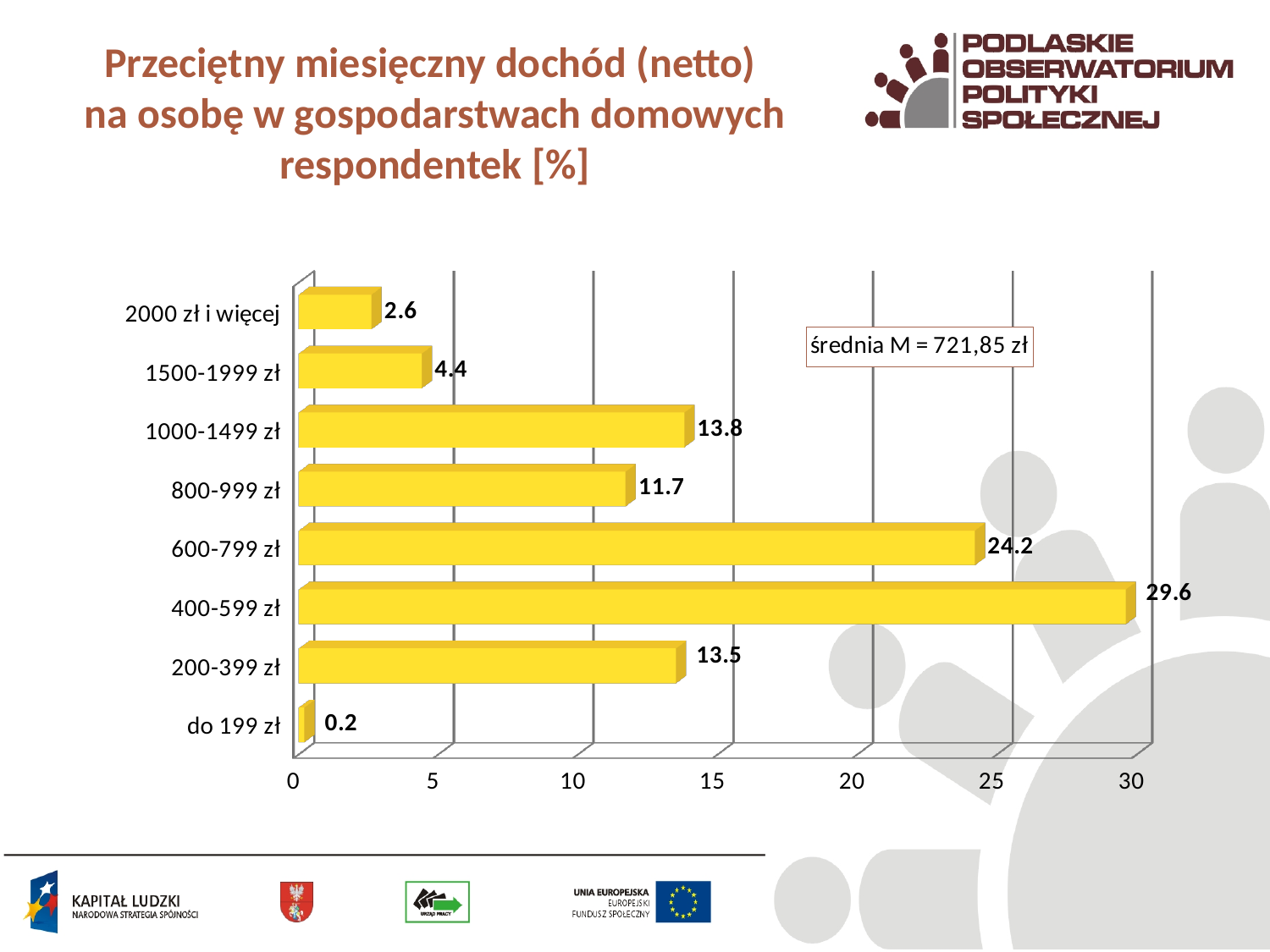
What is the difference between the values for 400-599 zł and 600-799 zł? 5.4 What is the value for the 1000-1499 zł category? 13.8 What is the mean value (średnia M) stated in the text box on the chart? 721,85 zł What kind of chart is shown on the slide? bar chart What is the value for the 400-599 zł category? 29.6 How many income categories are shown on the chart? 8 What is the value for the 2000 zł i więcej category? 2.6 Which category has the highest value? 400-599 zł Which is larger, the value for 800-999 zł or the value for 200-399 zł? 200-399 zł Is the value for 600-799 zł greater or less than 20? greater What is the difference between the values for 1500-1999 zł and 2000 zł i więcej? 1.8 Which category has the lowest value? do 199 zł